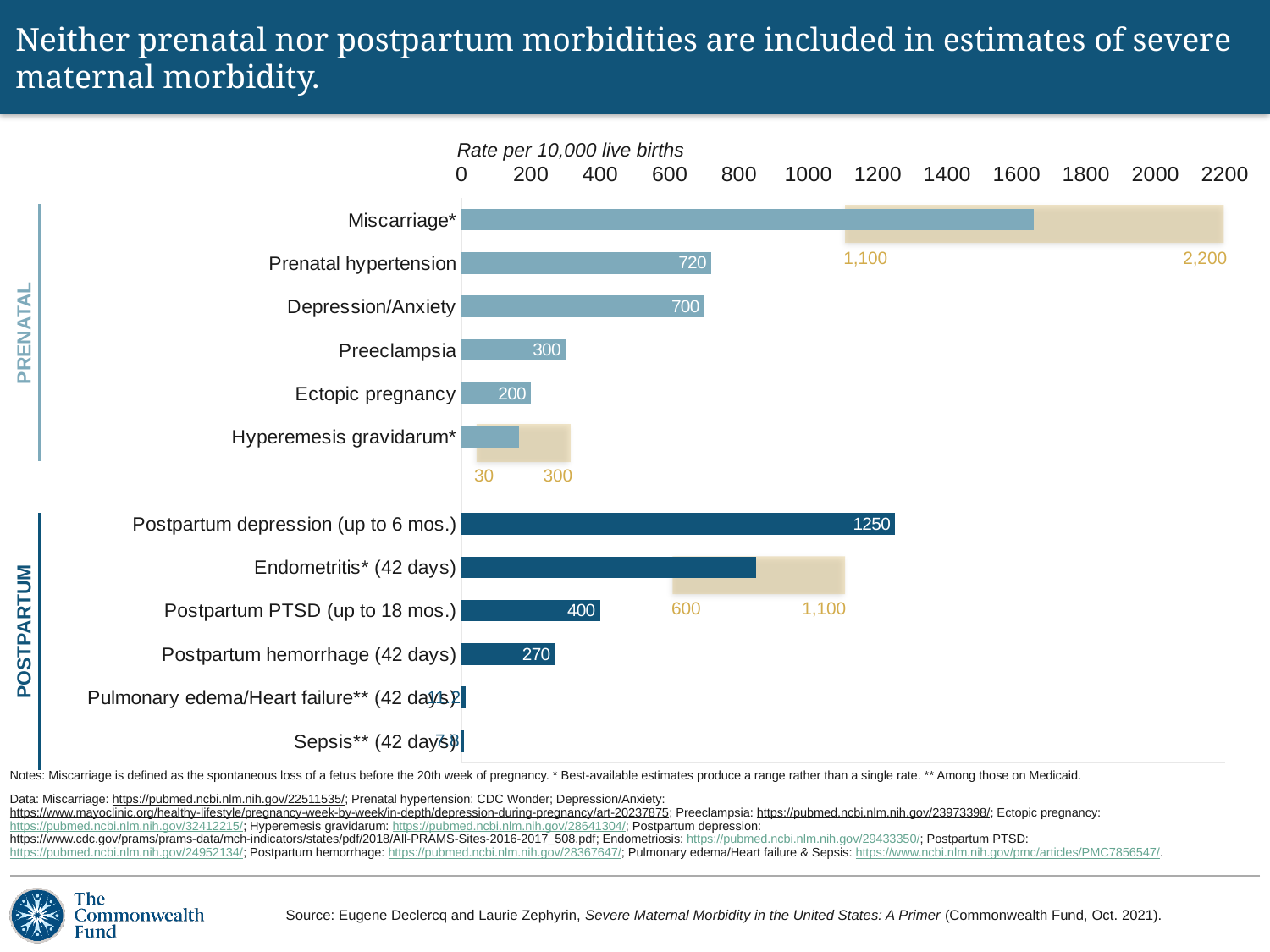
What is the rate per 10,000 live births for Ectopic pregnancy? 200 What is the difference between the rates for Prenatal hypertension and Depression/Anxiety? 20 Which has a higher rate, Postpartum PTSD (up to 18 mos.) or Preeclampsia? Postpartum PTSD (up to 18 mos.) What unit is the chart's axis measured in? Rate per 10,000 live births What is the rate per 10,000 live births for Prenatal hypertension? 720 What type of chart is shown on the slide? Bar chart Among the single-rate postpartum conditions, which has the highest rate? Postpartum depression (up to 6 mos.) What range of rates is shown for Miscarriage*? 1,100 to 2,200 How many conditions are listed on the chart? 12 What range of rates is shown for Endometritis* (42 days)? 600 to 1,100 What is the rate per 10,000 live births for Postpartum depression (up to 6 mos.)? 1250 What is the rate per 10,000 live births for Postpartum hemorrhage (42 days)? 270